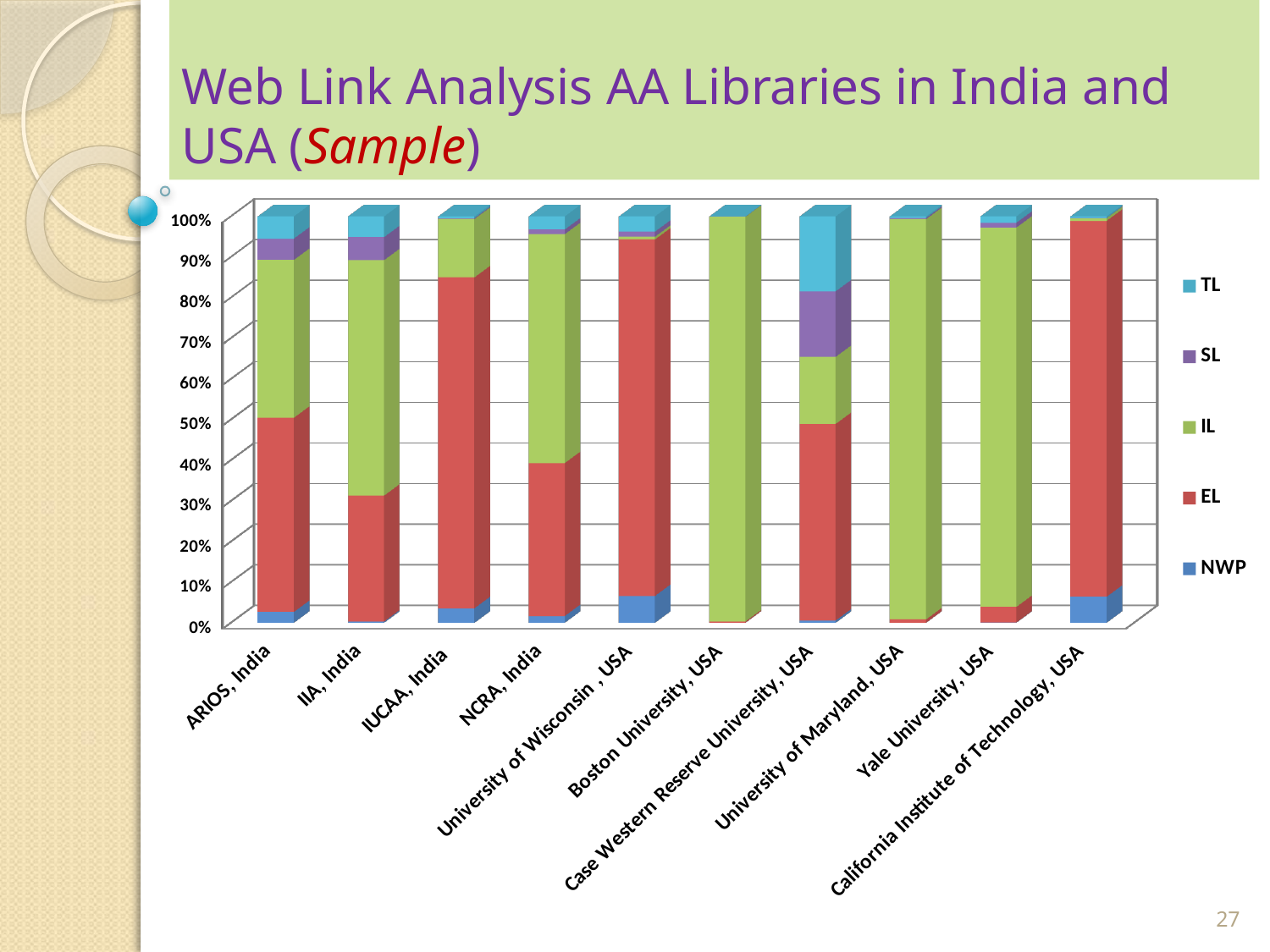
Is the TL share for Case Western Reserve University, USA greater or less than 10%? greater Is the IL share for Boston University, USA greater or less than 90%? greater Which library has the largest EL share? California Institute of Technology, USA Which has the larger EL share, IUCAA, India or NCRA, India? IUCAA, India Is the EL share for NCRA, India greater or less than 50%? less How many series does the chart legend list? 5 Which library has the largest TL share? Case Western Reserve University, USA What kind of chart is shown on the slide? Stacked bar chart What is the title of the chart slide? Web Link Analysis AA Libraries in India and USA (Sample) Which series in the legend is shown in green? IL How many libraries (categories) are shown on the x axis of the chart? 10